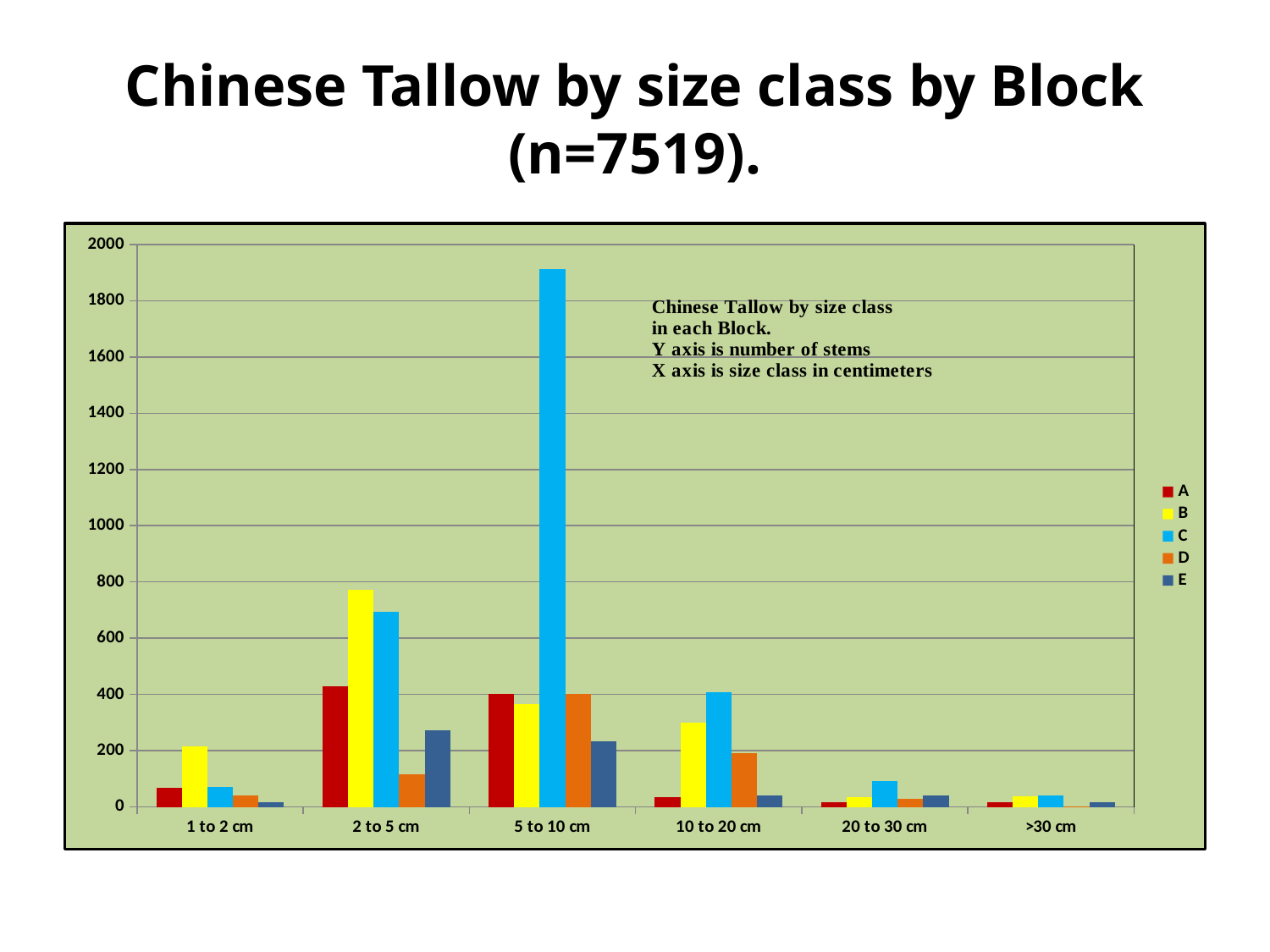
In the 2 to 5 cm size class, which is larger, block B or block C? B Is the value for block C in the 5 to 10 cm size class greater or less than 1800? greater What are the legend entries of the chart? A, B, C, D, E How many size classes are shown on the x axis? 6 Which block has the lowest bar in the 2 to 5 cm size class? D Which block has the tallest bar in the 5 to 10 cm size class? C Is the value for block A in the 2 to 5 cm size class greater or less than 200? greater In the 10 to 20 cm size class, which is larger, block B or block C? C What kind of chart is shown on the slide? bar chart Which block has the highest bar in the 1 to 2 cm size class? B How many series does the legend list? 5 Is the value for block B in the 2 to 5 cm size class greater or less than 600? greater